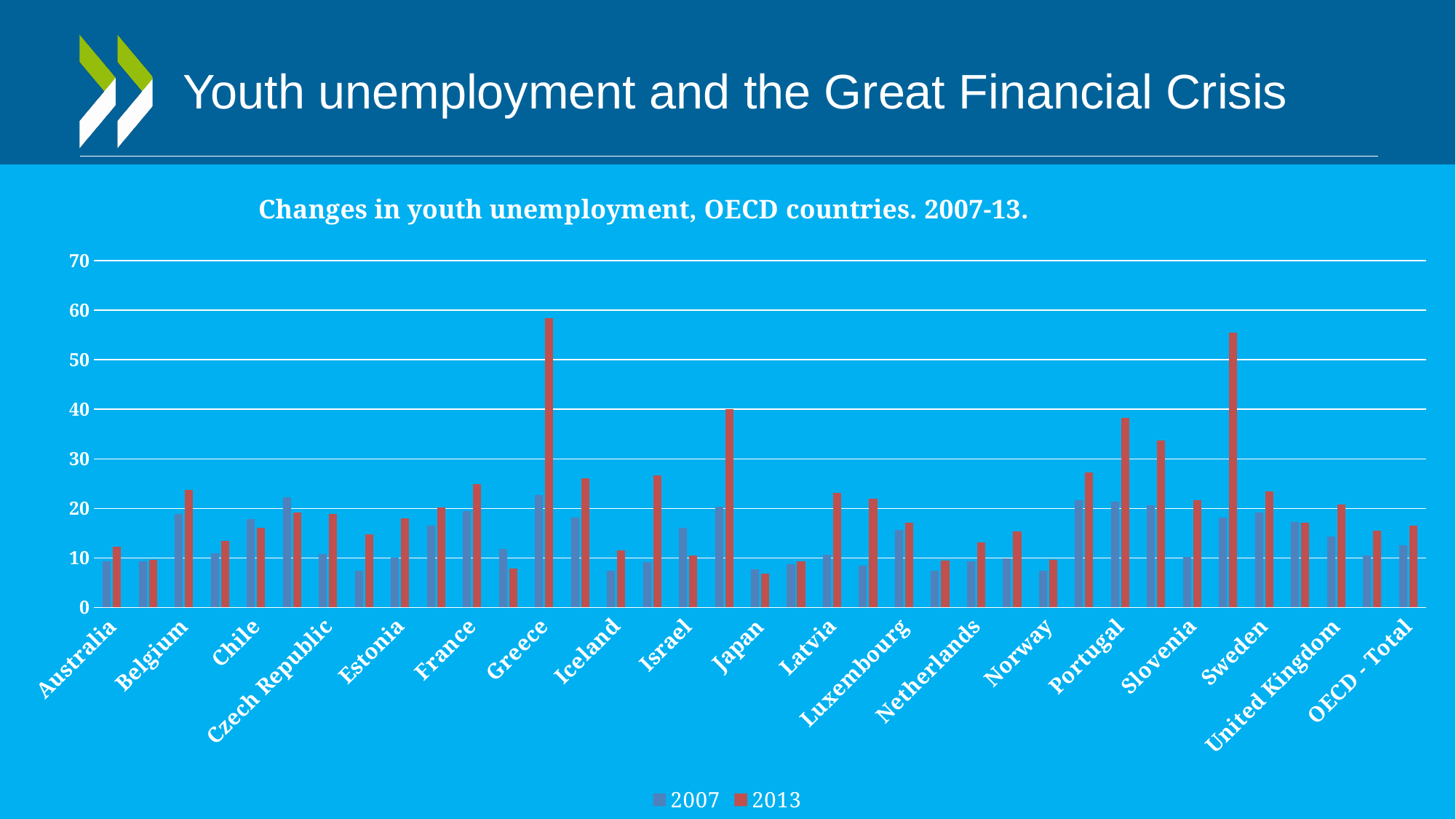
Is the 2013 value for Latvia greater or less than 20? greater What kind of chart is shown on the slide? bar chart For Israel, which is larger: the 2007 value or the 2013 value? 2007 What is the title of the chart? Changes in youth unemployment, OECD countries. 2007-13. Which labelled country has the highest 2013 value? Greece Which two years are shown in the legend? 2007 and 2013 How many series does the legend list? 2 For Greece, which is larger: the 2007 value or the 2013 value? 2013 Is the 2013 value for Greece greater or less than 50? greater Is the 2013 value for Japan greater or less than 10? less